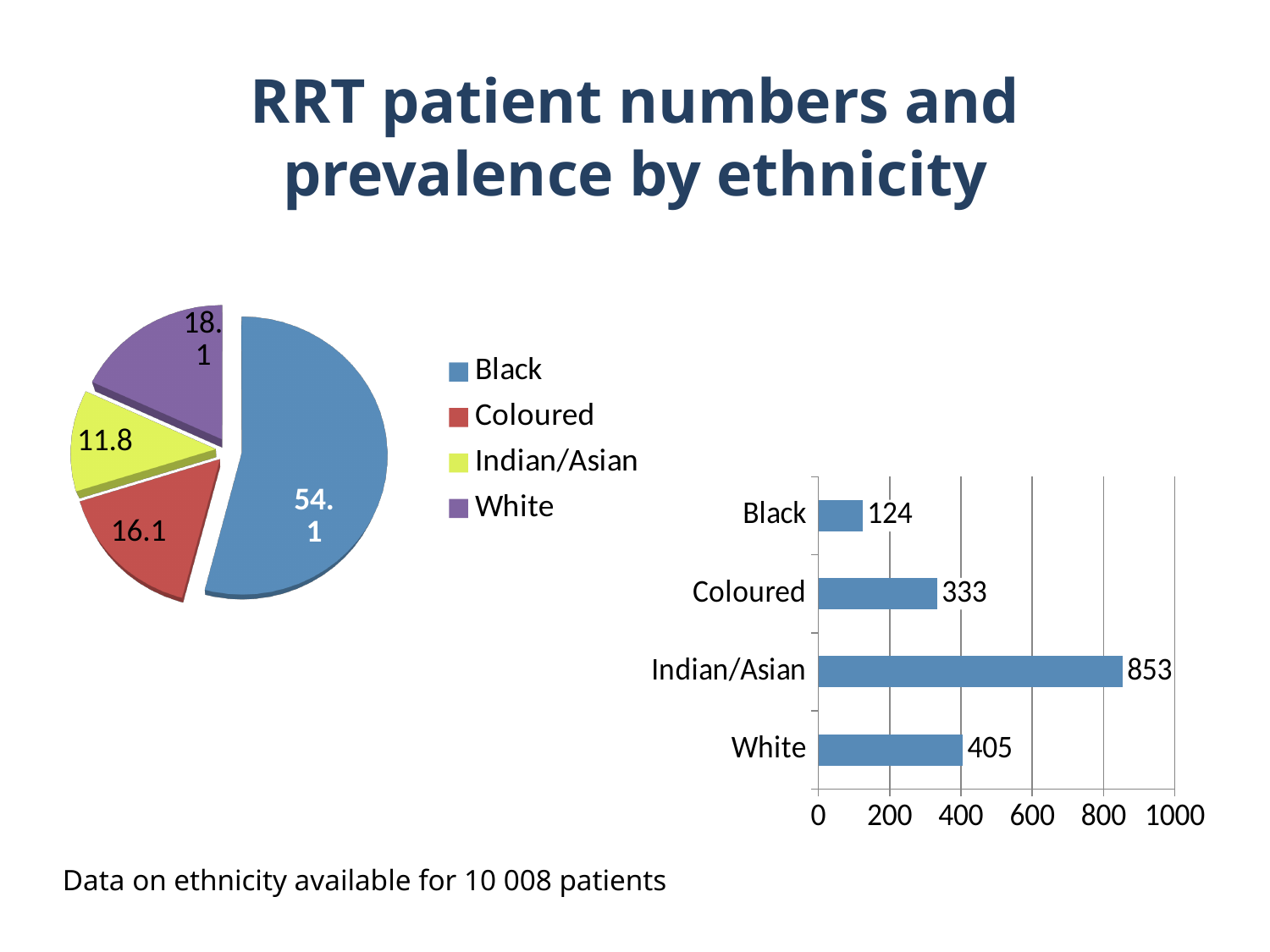
In the pie chart on the left, what colour is the White slice? Purple In the bar chart on the right, what is the difference between the values for White and Coloured? 72 What type of chart is shown on the right of the slide? Bar chart In the bar chart on the right, what is the value for Indian/Asian? 853 In the bar chart on the right, which ethnicity has the lowest value? Black In the pie chart on the left, which ethnicity has the largest slice? Black In the bar chart on the right, which ethnicity has the highest value? Indian/Asian In the pie chart on the left, how many slices are there? 4 In the bar chart on the right, what is the value for Black? 124 In the pie chart on the left, which ethnicity has the smallest slice? Indian/Asian In the pie chart on the left, what is the value shown for the Black slice? 54.1 In the pie chart on the left, what is the value shown for the Coloured slice? 16.1